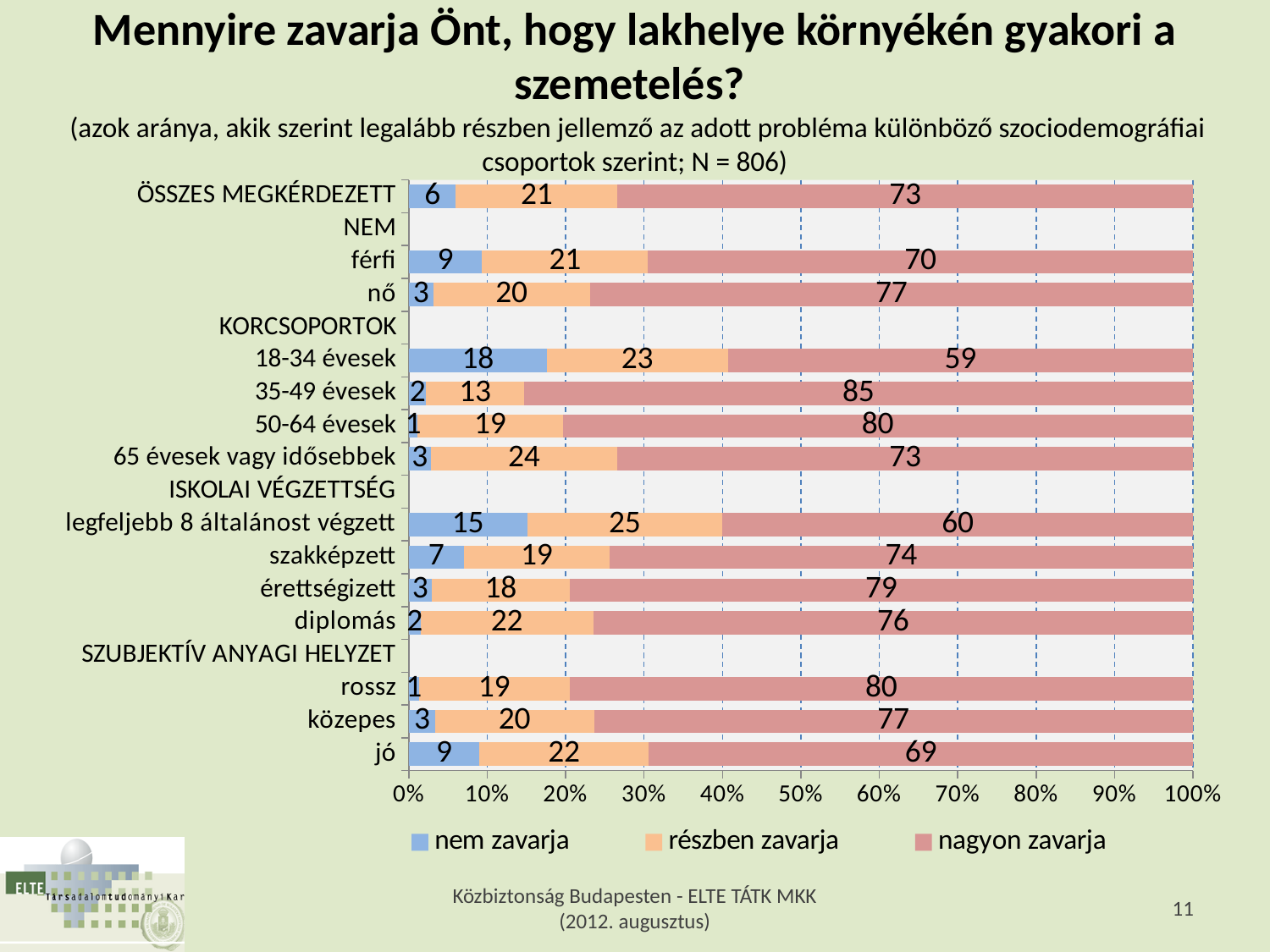
Which has a larger 'nem zavarja' value, legfeljebb 8 általánost végzett or szakképzett? legfeljebb 8 általánost végzett What is the value of 'nem zavarja' for 18-34 évesek? 18 What is the value of 'nagyon zavarja' for rossz? 80 How many series does the legend list? 3 What is the value of 'nagyon zavarja' for ÖSSZES MEGKÉRDEZETT? 73 Which legend entry is shown in blue? nem zavarja Which category has the highest 'nagyon zavarja' value? 35-49 évesek What is the total of the stacked bar for jó? 100 What is the difference between the 'nagyon zavarja' values for nő and férfi? 7 What is the value of 'részben zavarja' for 65 évesek vagy idősebbek? 24 Which category has the lowest 'nagyon zavarja' value? 18-34 évesek What type of chart is shown on the slide? stacked bar chart